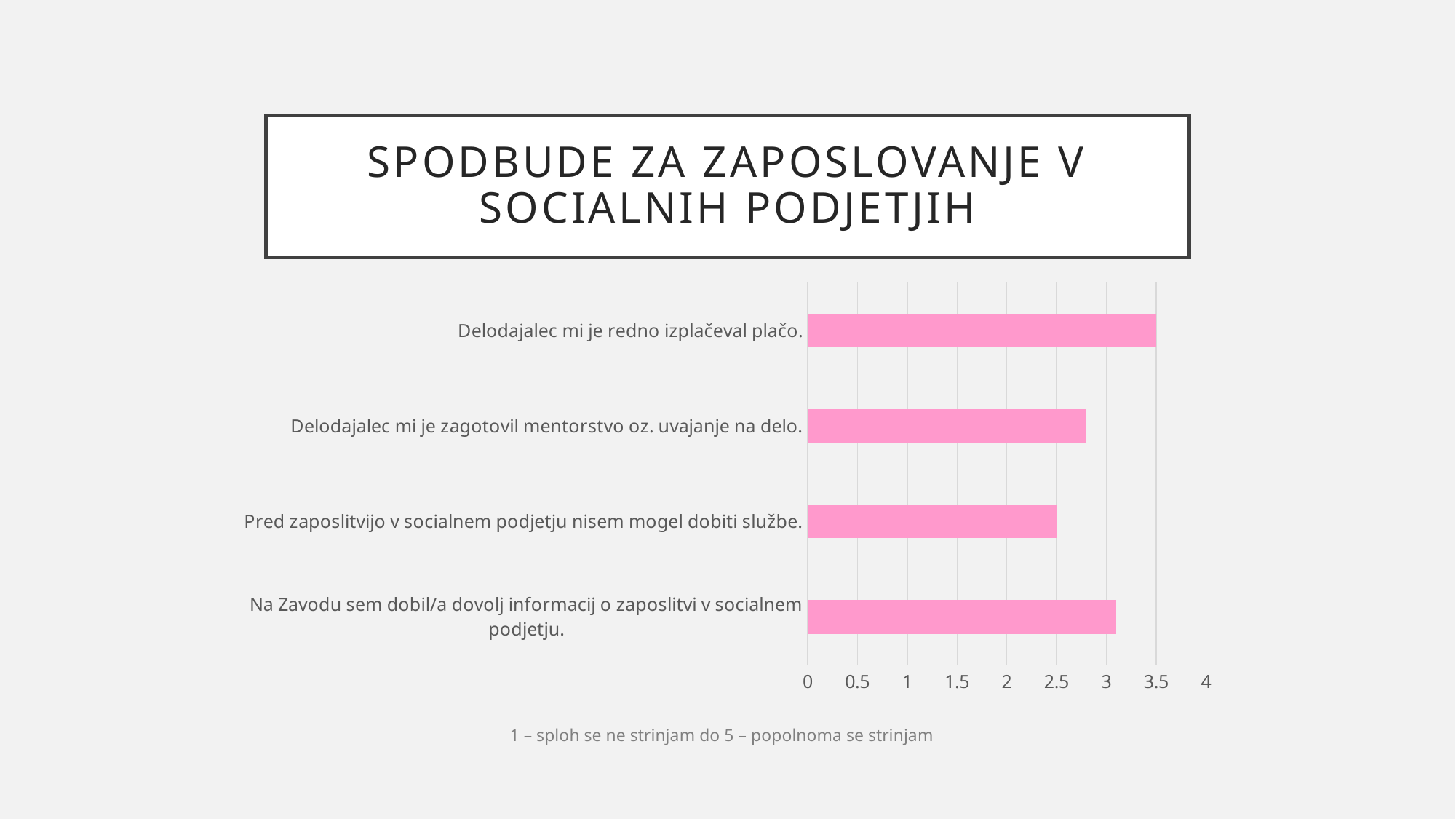
Which is larger: the value for "Na Zavodu sem dobil/a dovolj informacij o zaposlitvi v socialnem podjetju." or the value for "Delodajalec mi je zagotovil mentorstvo oz. uvajanje na delo."? Na Zavodu sem dobil/a dovolj informacij o zaposlitvi v socialnem podjetju. Is the value for "Na Zavodu sem dobil/a dovolj informacij o zaposlitvi v socialnem podjetju." greater or less than 3? greater What is the value for "Delodajalec mi je redno izplačeval plačo."? 3.5 What is the title of the slide containing the chart? SPODBUDE ZA ZAPOSLOVANJE V SOCIALNIH PODJETJIH Is the value for "Delodajalec mi je zagotovil mentorstvo oz. uvajanje na delo." greater or less than 3? less What is the maximum value shown on the horizontal axis of the chart? 4 What kind of chart is shown on the slide? bar chart Is the value for "Delodajalec mi je zagotovil mentorstvo oz. uvajanje na delo." greater or less than 2.5? greater How many categories (statements) are plotted in the chart? 4 What is the value for "Pred zaposlitvijo v socialnem podjetju nisem mogel dobiti službe."? 2.5 Which statement has the lowest value in the chart? Pred zaposlitvijo v socialnem podjetju nisem mogel dobiti službe. Which statement has the highest value in the chart? Delodajalec mi je redno izplačeval plačo.